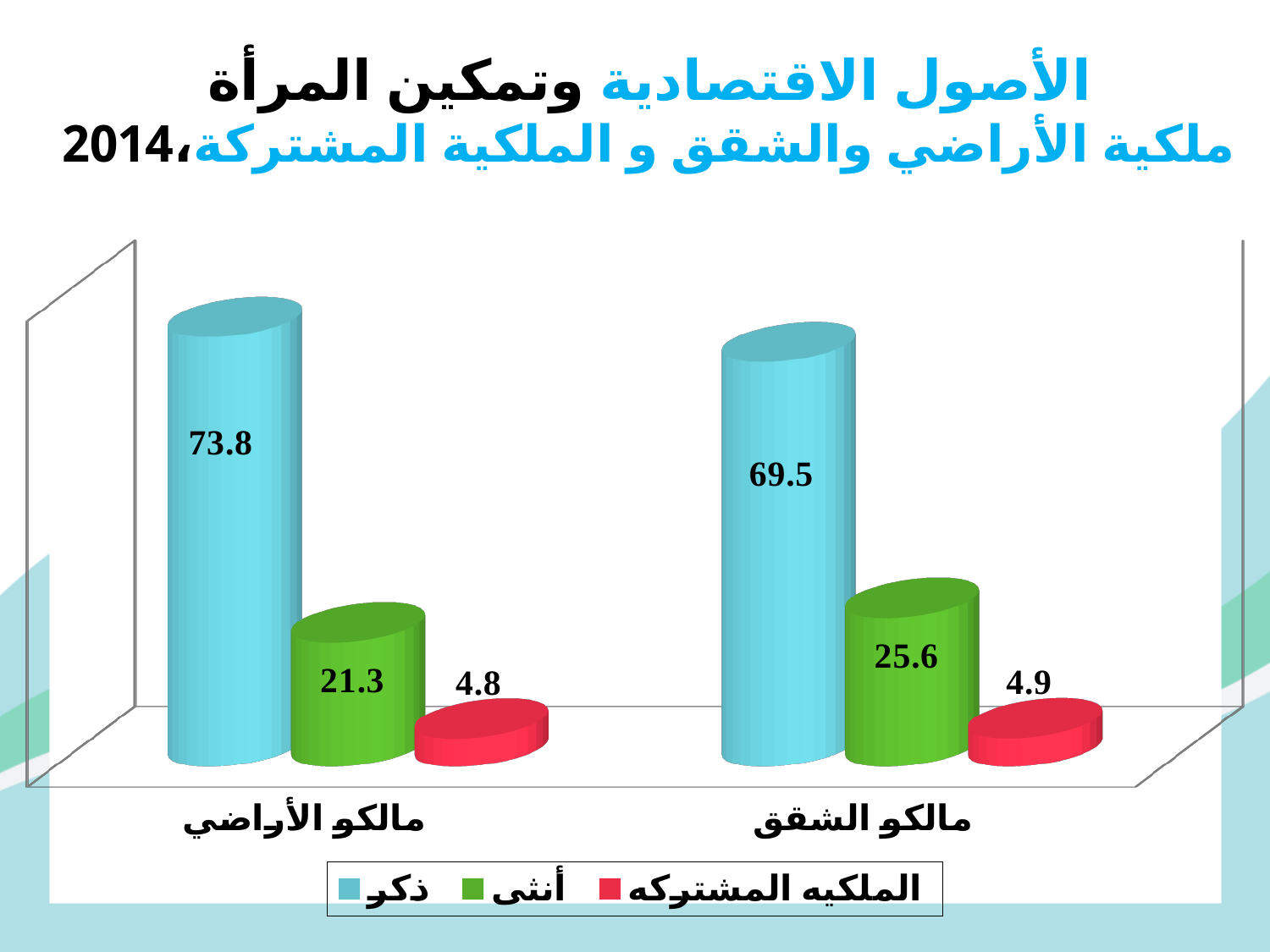
Which series has the lowest value in the مالكو الأراضي category? الملكية المشتركة What is the difference between the أنثى (female) values for مالكو الشقق and مالكو الأراضي? 4.3 How many categories are shown on the x axis? 2 Which is larger: the ذكر (male) value for مالكو الأراضي or for مالكو الشقق? مالكو الأراضي What kind of chart is shown on the slide? Bar chart What is the value for ذكر (male) in the مالكو الشقق category? 69.5 How many series does the legend list? 3 What is the value for ذكر (male) in the مالكو الأراضي category? 73.8 What is the value for أنثى (female) in the مالكو الشقق category? 25.6 What is the difference between the ذكر (male) and أنثى (female) values in the مالكو الأراضي category? 52.5 Which series has the highest value in the مالكو الشقق category? ذكر What is the value for الملكية المشتركة (joint ownership) in the مالكو الأراضي category? 4.8